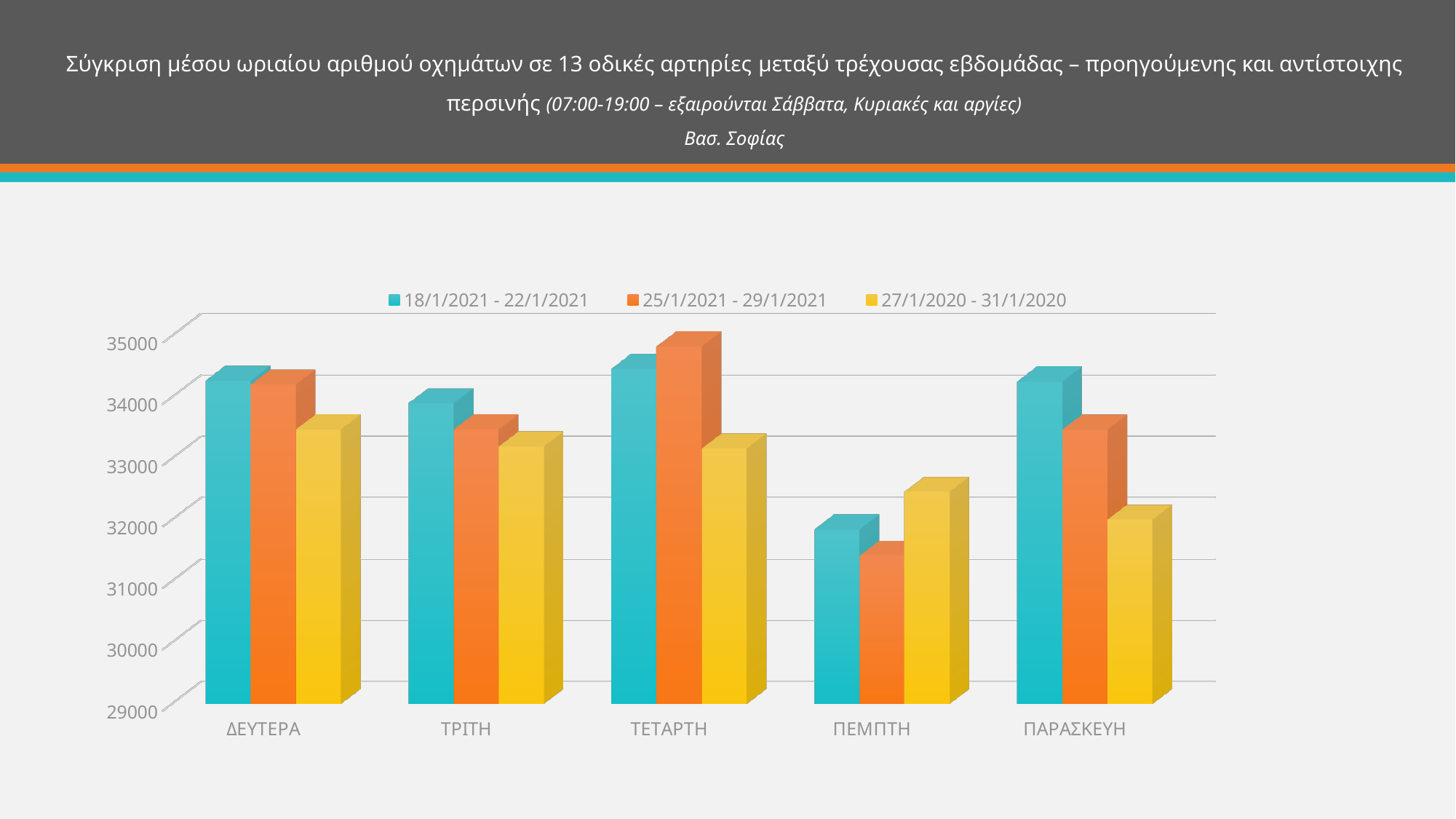
Is the value for 25/1/2021 - 29/1/2021 on ΠΕΜΠΤΗ greater or less than 32000? less For the series 27/1/2020 - 31/1/2020, which day has the lowest value? ΠΑΡΑΣΚΕΥΗ For the series 18/1/2021 - 22/1/2021, which day has the lowest value? ΠΕΜΠΤΗ How many categories (days) are shown on the x axis? 5 For the series 25/1/2021 - 29/1/2021, which day has the highest value? ΤΕΤΑΡΤΗ On ΠΑΡΑΣΚΕΥΗ, which series has the larger value: 18/1/2021 - 22/1/2021 or 27/1/2020 - 31/1/2020? 18/1/2021 - 22/1/2021 Is the value for 25/1/2021 - 29/1/2021 on ΤΕΤΑΡΤΗ greater or less than 34000? greater Which road artery is named in the subtitle of the chart? Βασ. Σοφίας How many series does the legend list? 3 Is the value for 27/1/2020 - 31/1/2020 on ΔΕΥΤΕΡΑ greater or less than 33000? greater On ΠΕΜΠΤΗ, which series has the larger value: 25/1/2021 - 29/1/2021 or 27/1/2020 - 31/1/2020? 27/1/2020 - 31/1/2020 What kind of chart is shown on the slide? bar chart